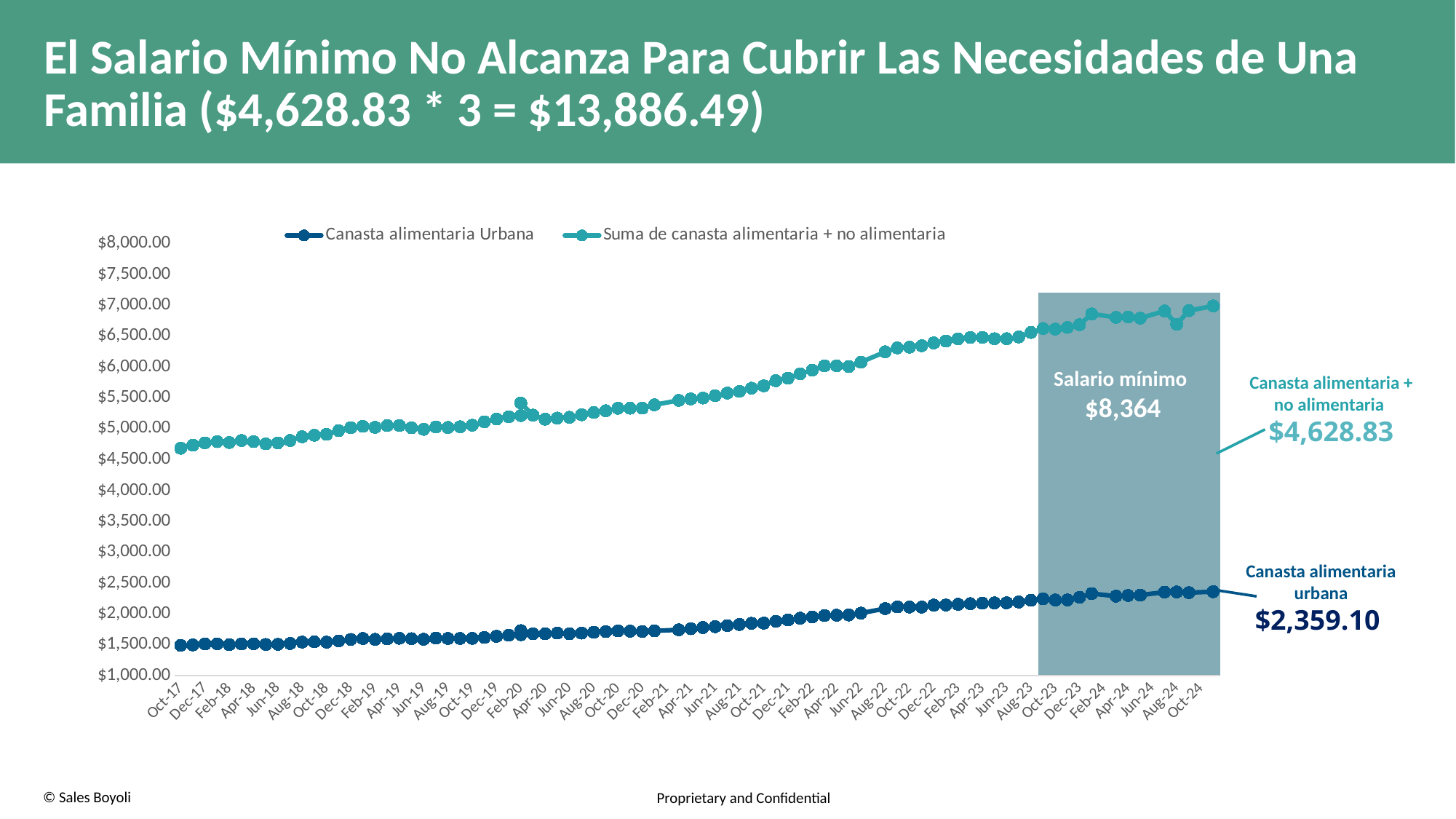
Is the value for 'Suma de canasta alimentaria + no alimentaria' at Oct-17 greater or less than $5,000.00? less What is the first label on the x axis of the chart? Oct-17 Which series is plotted higher on the chart, 'Canasta alimentaria Urbana' or 'Suma de canasta alimentaria + no alimentaria'? Suma de canasta alimentaria + no alimentaria What value is printed in the annotation for 'Canasta alimentaria + no alimentaria' at the right of the chart? $4,628.83 What value is printed in the annotation for 'Canasta alimentaria urbana' at the right of the chart? $2,359.10 Is the value for 'Canasta alimentaria Urbana' at Oct-17 greater or less than $2,000.00? less What 'Salario mínimo' value is printed in the shaded area of the chart? $8,364 What kind of chart is shown on the slide? line chart Is the value for 'Suma de canasta alimentaria + no alimentaria' at Oct-24 greater or less than $6,500.00? greater How many series does the chart legend list? 2 Do the values of the 'Suma de canasta alimentaria + no alimentaria' series rise or fall from Oct-17 to Oct-24? rise What is the difference between the annotated values $4,628.83 (Canasta alimentaria + no alimentaria) and $2,359.10 (Canasta alimentaria urbana)? $2,269.73